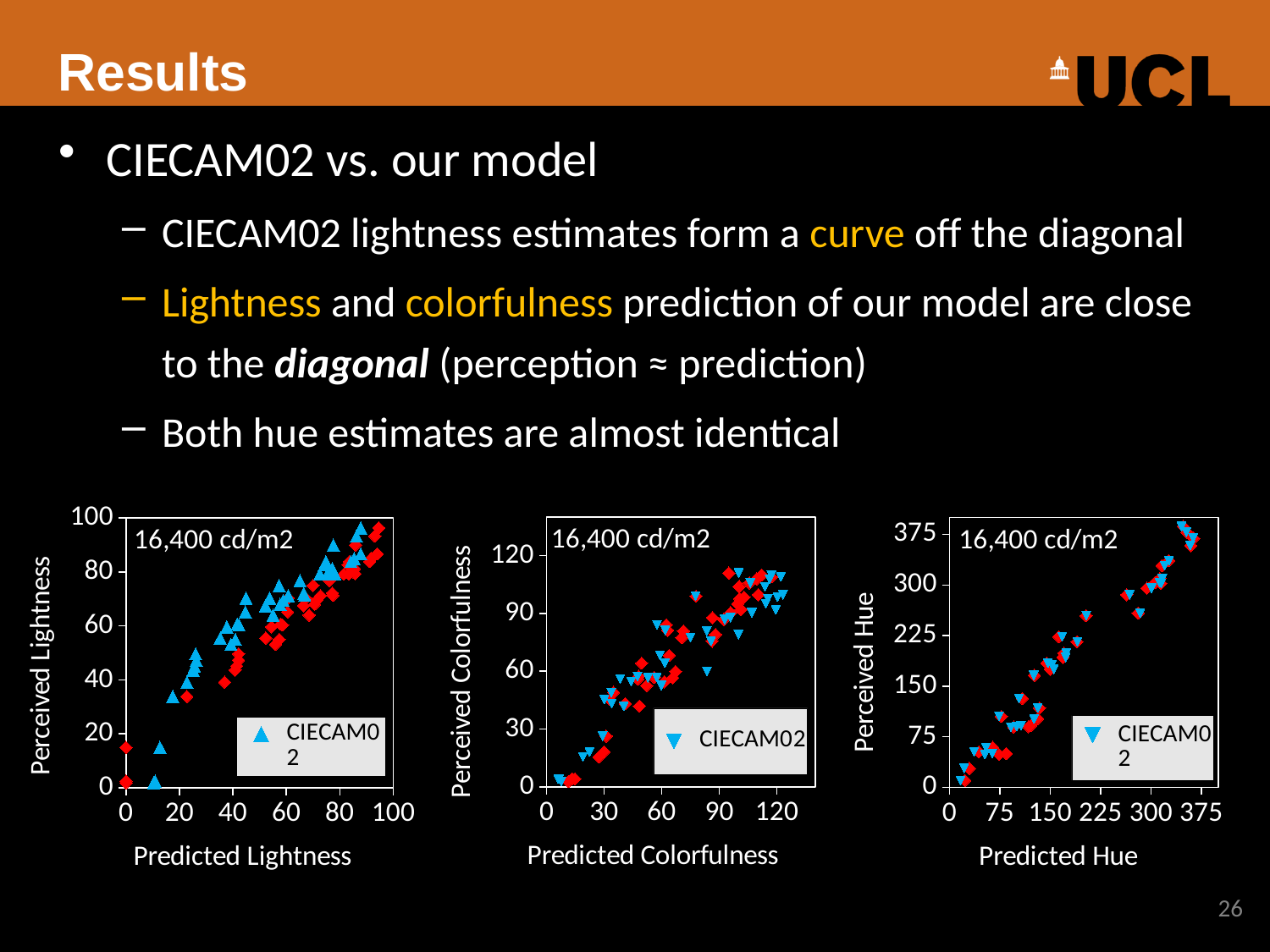
What is the highest tick value on the y axis of the right chart (Perceived Hue)? 375 What is the y-axis label of the middle chart? Perceived Colorfulness What is the highest tick value on the x axis of the left chart (Predicted Lightness)? 100 In the left chart (Predicted Lightness vs Perceived Lightness), do the points rise or fall as Predicted Lightness increases? rise What kind of chart is the left chart with x axis 'Predicted Lightness'? scatter chart How many charts are shown on the slide? 3 What is the x-axis label of the right chart? Predicted Hue What luminance condition is printed inside each of the three charts? 16,400 cd/m2 In the right chart (Predicted Hue vs Perceived Hue), do the points rise or fall as Predicted Hue increases? rise What is the highest tick value on the x axis of the middle chart (Predicted Colorfulness)? 120 What series name is listed in the legend of the middle chart (Predicted Colorfulness vs Perceived Colorfulness)? CIECAM02 In the middle chart (Predicted Colorfulness vs Perceived Colorfulness), do the points rise or fall as Predicted Colorfulness increases? rise